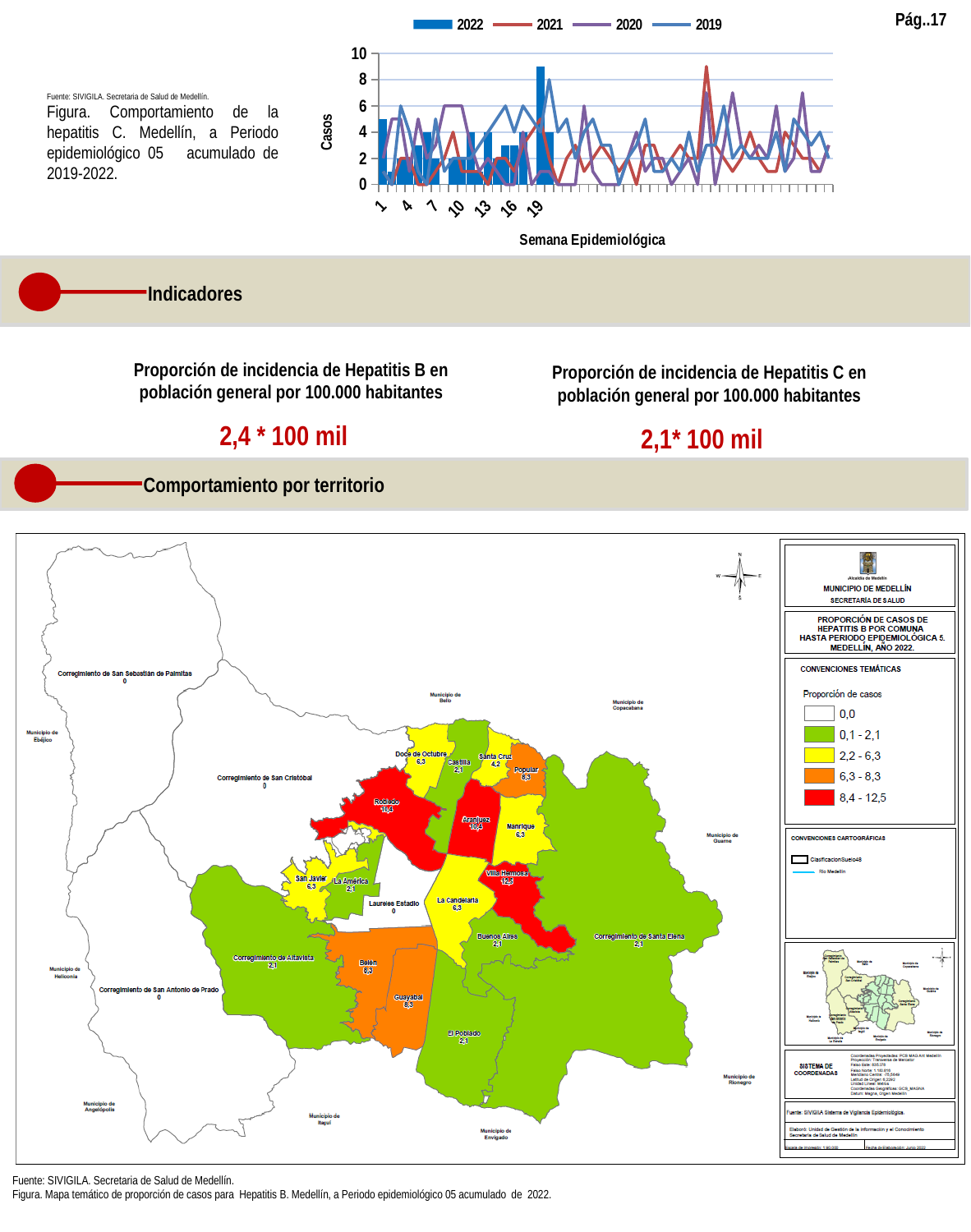
On the map of Hepatitis B cases by comuna, which comuna has the highest printed proportion? Villa Hermosa On the map of Hepatitis B cases by comuna, what is the proportion shown for Robledo? 11,4 In the top chart, is the value for 2022 at week 19 greater or less than 6? greater On the map of Hepatitis B cases by comuna, what is the proportion shown for Villa Hermosa? 12,5 Which years are listed in the legend of the top chart? 2022, 2021, 2020, 2019 What is the title of the vertical axis of the top chart? Casos How many series does the legend of the top chart list? 4 In the top chart, is the value for 2022 at week 1 greater or less than 4? greater On the map of Hepatitis B cases by comuna, what is the difference between the proportions for Villa Hermosa and Robledo? 1,1 In the top chart, how is the 2022 series drawn, as bars or as a line? As bars On the map of Hepatitis B cases by comuna, which has the larger proportion, Aranjuez or Manrique? Aranjuez In the top chart, does the 2021 line ever rise above 8 cases? Yes